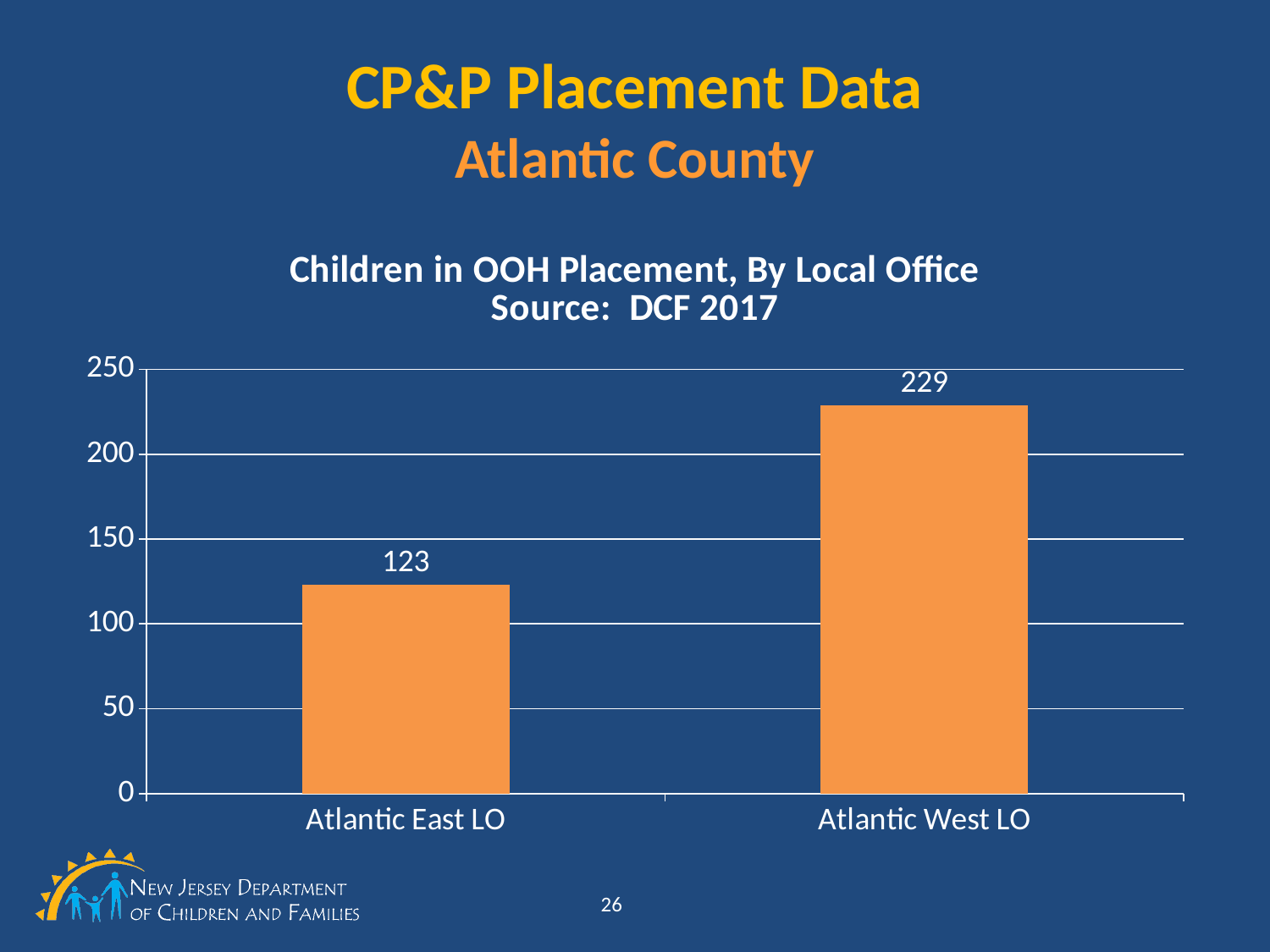
What kind of chart is shown on the slide? bar chart What is the value for Atlantic West LO? 229 Which local office has the lowest number of children in OOH placement? Atlantic East LO Which local office has the highest number of children in OOH placement? Atlantic West LO What is the value for Atlantic East LO? 123 Which is larger, the value for Atlantic East LO or Atlantic West LO? Atlantic West LO Is the value for Atlantic East LO greater or less than 150? less Is the value for Atlantic West LO greater or less than 200? greater What is the highest value shown on the vertical axis? 250 What is the title of the chart? Children in OOH Placement, By Local Office Source: DCF 2017 How many local offices are shown in the chart? 2 What is the difference between the values for Atlantic West LO and Atlantic East LO? 106